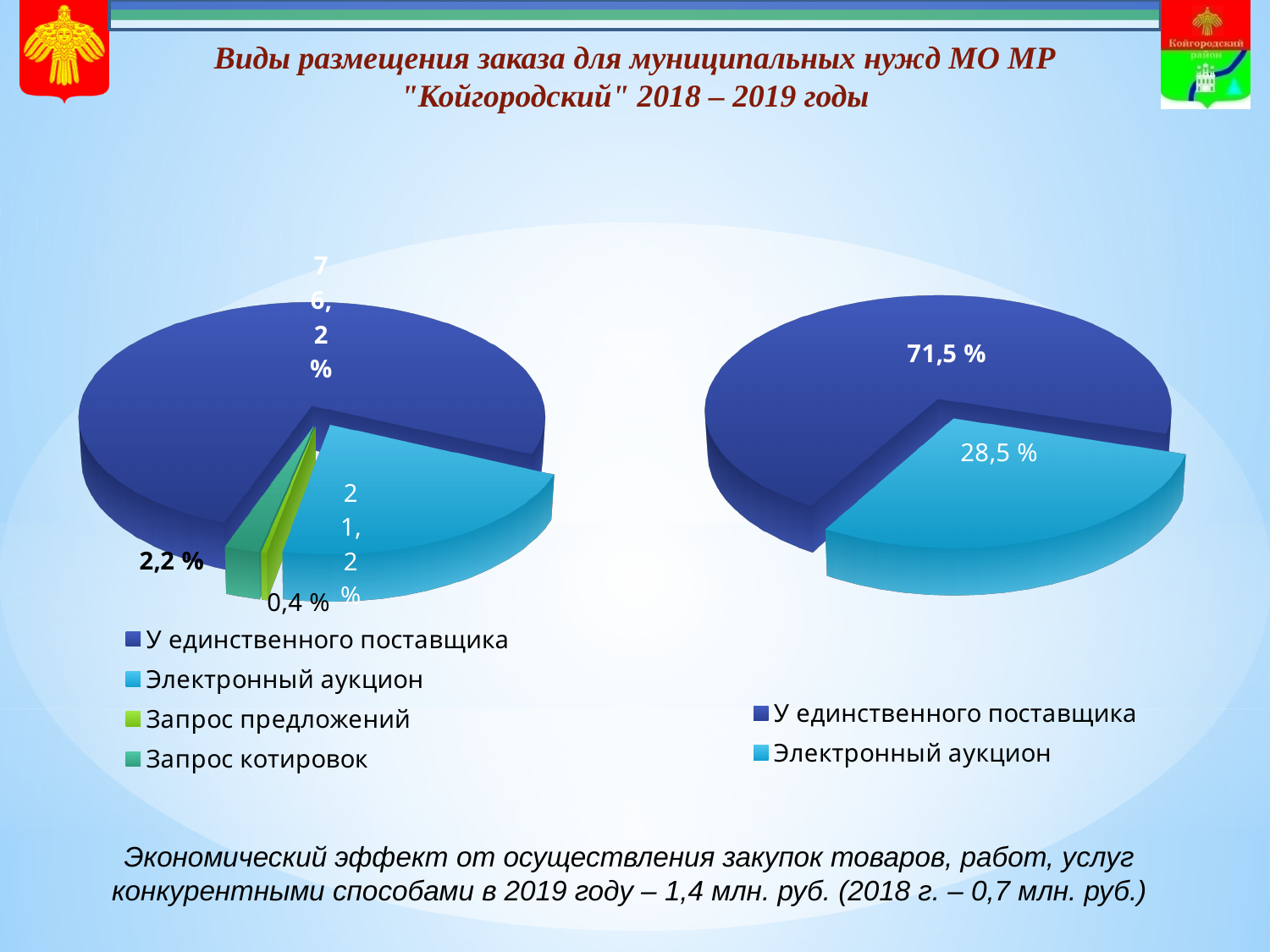
What kind of chart is the left chart on the slide? pie chart In the left pie chart, which category has the largest share? У единственного поставщика In the left pie chart, what share is shown for Электронный аукцион? 21,2 % What is the smallest percentage value labelled on the left pie chart? 0,4 % In the right pie chart, what share is shown for У единственного поставщика? 71,5 % How many categories does the legend of the left pie chart list? 4 Is the share of У единственного поставщика larger in the left pie chart or in the right pie chart? left pie chart How many categories does the legend of the right pie chart list? 2 In the left pie chart, what share is shown for У единственного поставщика? 76,2 % In the right pie chart, what is the difference between the shares of У единственного поставщика and Электронный аукцион? 43 % In the right pie chart, which category has the smaller share? Электронный аукцион In the right pie chart, what share is shown for Электронный аукцион? 28,5 %